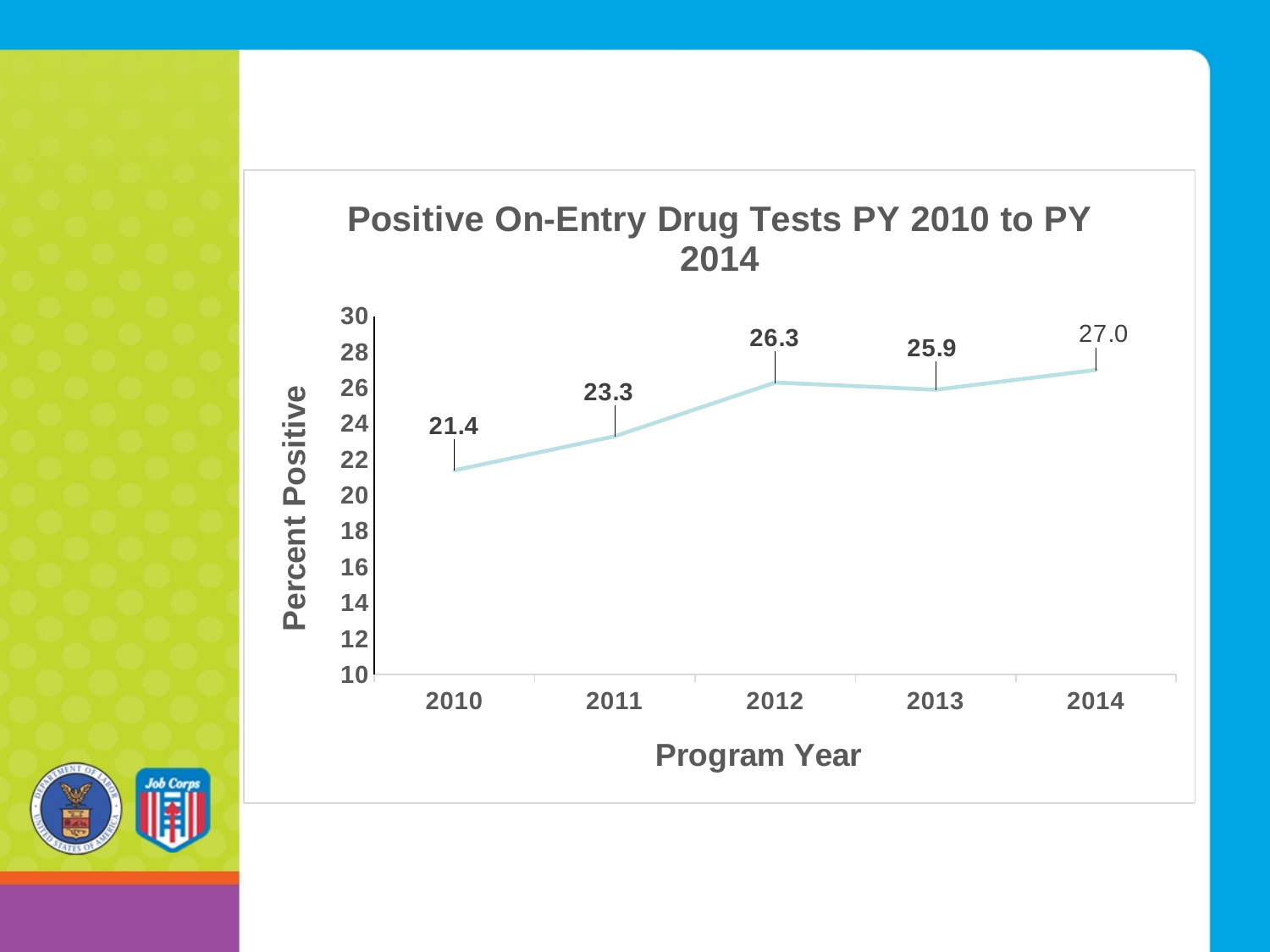
Which program year has the lowest percent positive? 2010 What is the difference in percent positive between 2012 and 2013? 0.4 What is the difference in percent positive between 2014 and 2010? 5.6 Is the value for 2011 greater or less than 24? less What is the percent positive for program year 2010? 21.4 What is the percent positive for program year 2014? 27.0 How many program years are plotted on the chart? 5 What is the title of the chart? Positive On-Entry Drug Tests PY 2010 to PY 2014 What is the percent positive for program year 2012? 26.3 Which program year has a higher percent positive, 2011 or 2013? 2013 Which program year has the highest percent positive? 2014 What kind of chart is shown on the slide? line chart